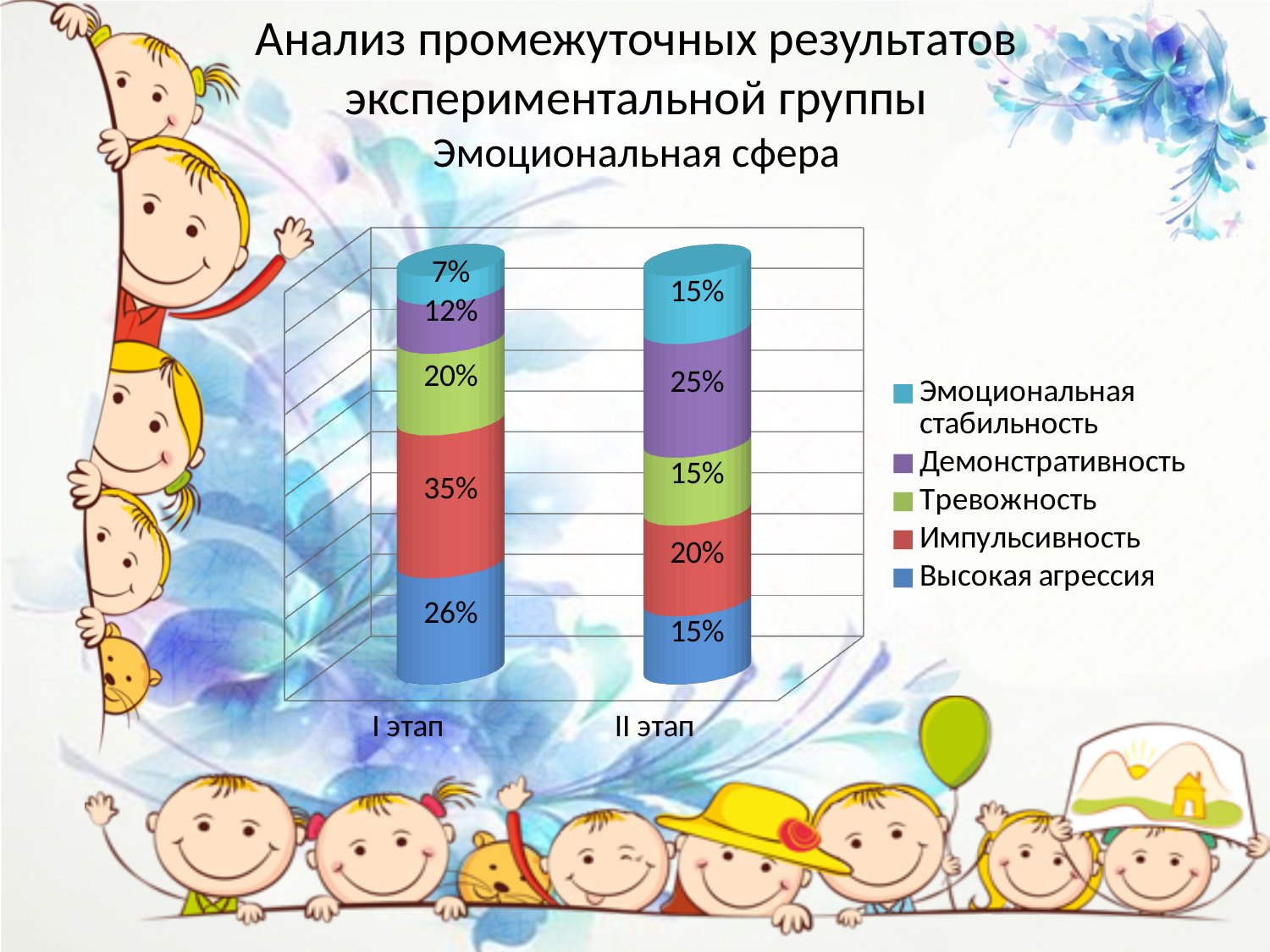
What kind of chart is shown on the slide? stacked bar chart What is the total of the stacked bar for II этап? 100% How many series does the legend list? 5 How many categories are shown on the x axis? 2 Which is larger: Тревожность at I этап or Тревожность at II этап? I этап Which series has the smallest value at I этап? Эмоциональная стабильность What is the value for Импульсивность at I этап? 35% What is the value for Демонстративность at II этап? 25% Which series has the largest value at I этап? Импульсивность What is the value for Эмоциональная стабильность at I этап? 7% What is the difference between Импульсивность at I этап and Импульсивность at II этап? 15% What is the value for Высокая агрессия at II этап? 15%